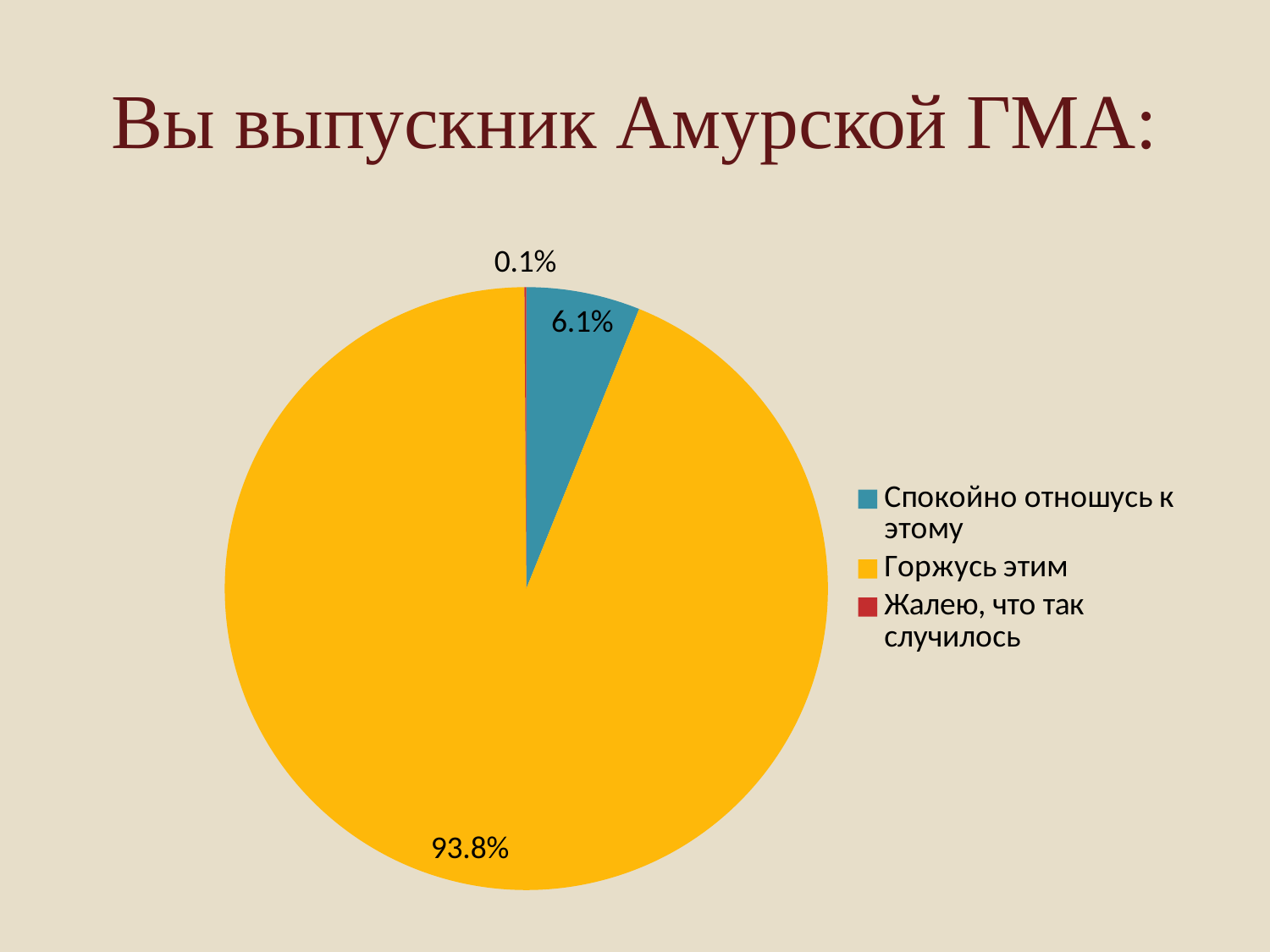
Which category has the smallest slice of the pie? Жалею, что так случилось What share of the pie is labelled "Жалею, что так случилось"? 0.1% How many categories does the pie chart have? 3 What is the title of the slide? Вы выпускник Амурской ГМА: What colour is the slice for "Горжусь этим"? yellow Which is larger: the share for "Спокойно отношусь к этому" or the share for "Жалею, что так случилось"? Спокойно отношусь к этому What kind of chart is shown on the slide? pie chart What share of the pie is labelled "Горжусь этим"? 93.8% Which category has the largest slice of the pie? Горжусь этим What is the difference between the shares for "Спокойно отношусь к этому" and "Жалею, что так случилось"? 6.0% What share of the pie is labelled "Спокойно отношусь к этому"? 6.1% What is the difference between the shares for "Горжусь этим" and "Спокойно отношусь к этому"? 87.7%